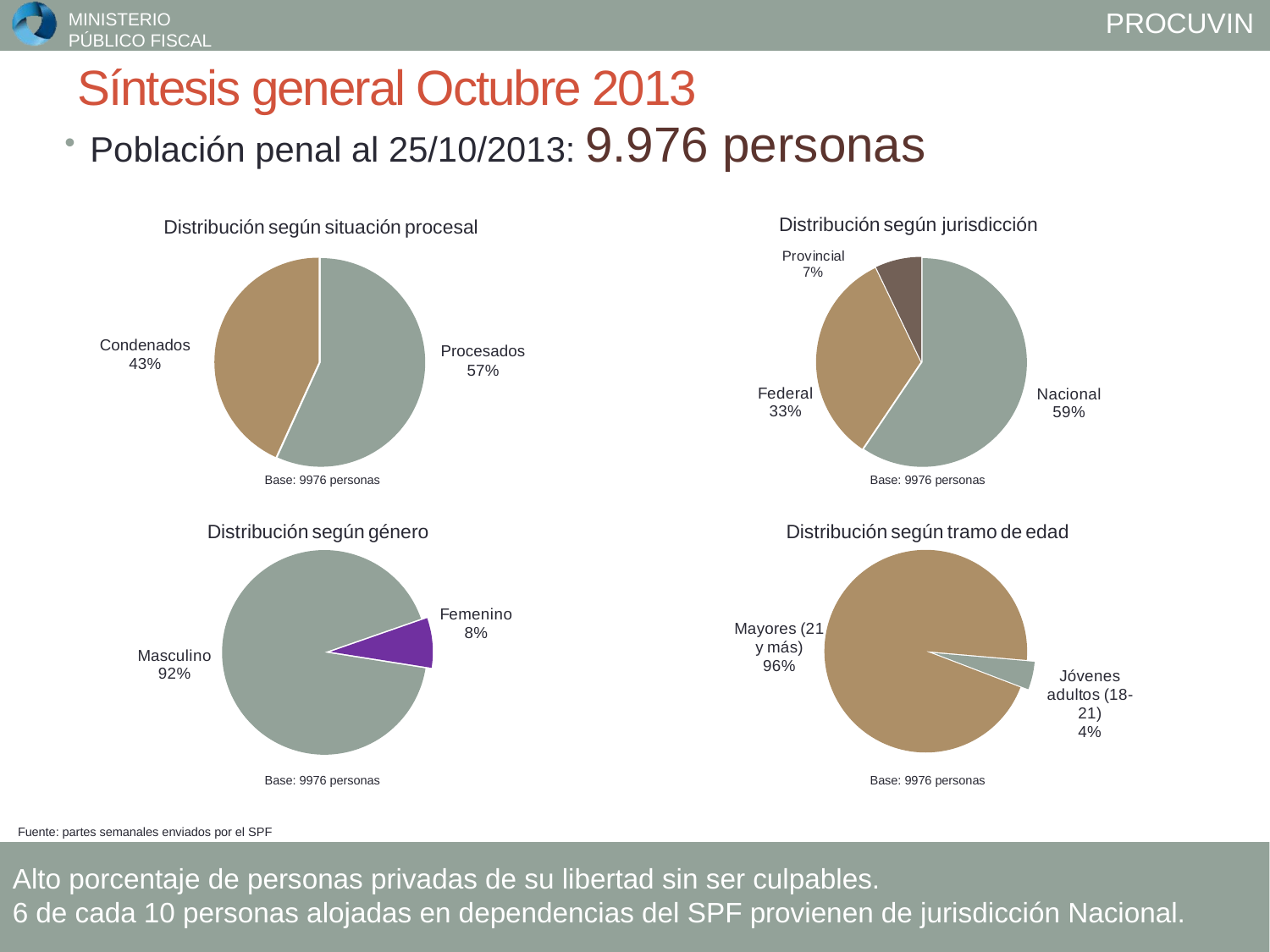
In the 'Distribución según jurisdicción' chart, which category has the smallest slice? Provincial In the 'Distribución según jurisdicción' chart, what is the difference between the Nacional and Federal shares? 26% In the 'Distribución según situación procesal' chart, what share of the pie is Procesados? 57% In the 'Distribución según jurisdicción' chart, how many categories are shown? 3 In the 'Distribución según tramo de edad' chart, what share of the pie is Jóvenes adultos (18-21)? 4% In the 'Distribución según situación procesal' chart, what is the value for Condenados? 43% In the 'Distribución según jurisdicción' chart, which category has the largest slice? Nacional In the 'Distribución según género' chart, what is the value for Femenino? 8% What kind of chart is 'Distribución según situación procesal'? Pie chart In the 'Distribución según tramo de edad' chart, what is the difference between Mayores (21 y más) and Jóvenes adultos (18-21)? 92% In the 'Distribución según género' chart, which is larger, Masculino or Femenino? Masculino What base (number of persons) is stated below each of the four charts? 9976 personas